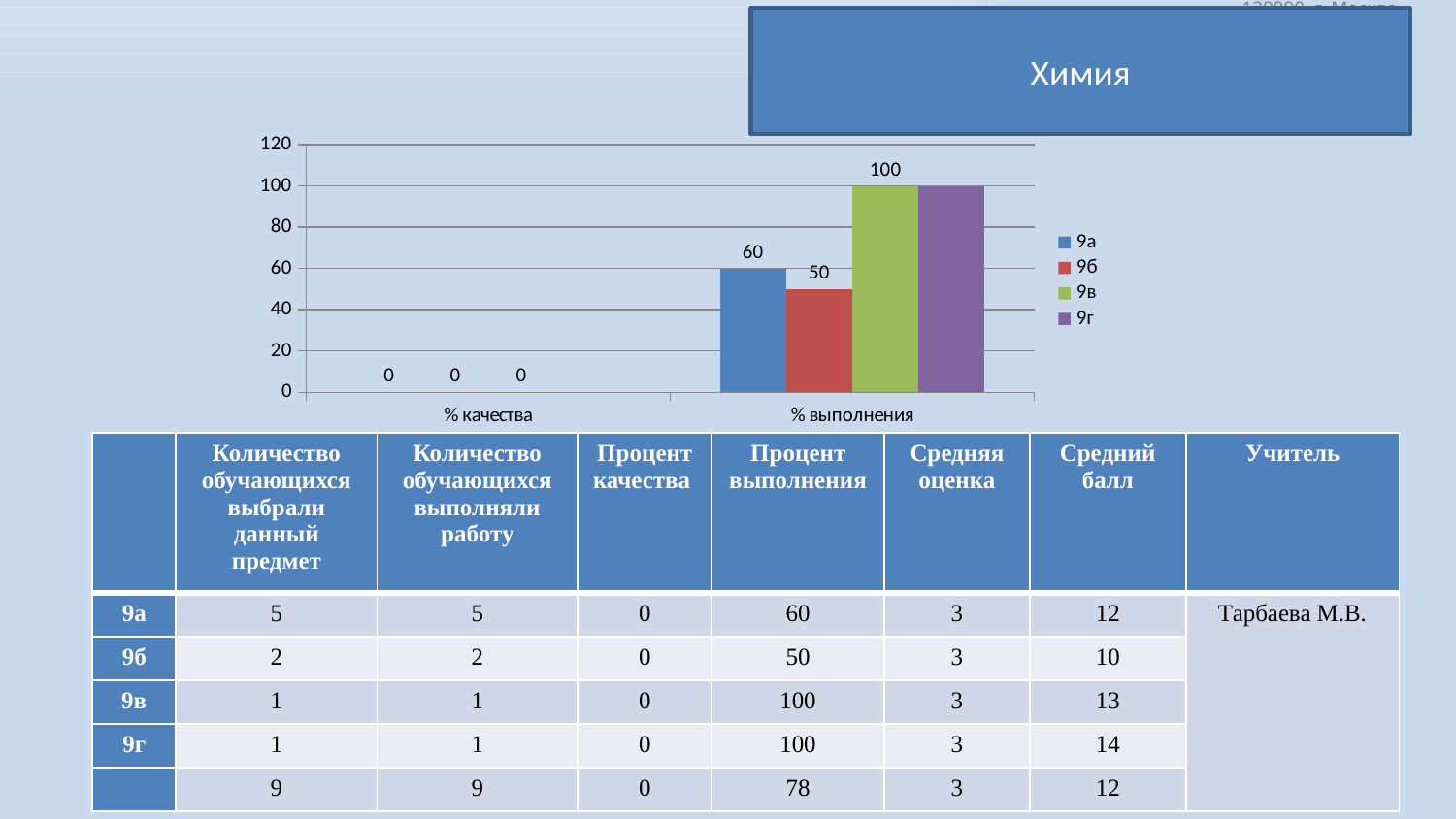
What is the value for 9а in the % выполнения category? 60 Which series has the lowest value in the % выполнения category? 9б Which is larger in the % выполнения category, the value for 9а or the value for 9б? 9а What is the difference between the % выполнения values for 9а and 9б? 10 What is the value for 9а in the % качества category? 0 Is the value for 9г in the % выполнения category greater or less than 80? greater What is the value for 9в in the % выполнения category? 100 What is the value for 9б in the % выполнения category? 50 How many categories are shown on the x axis of the chart? 2 What type of chart is shown on the slide? bar chart How many series does the chart legend list? 4 What is the title shown in the box above the chart? Химия